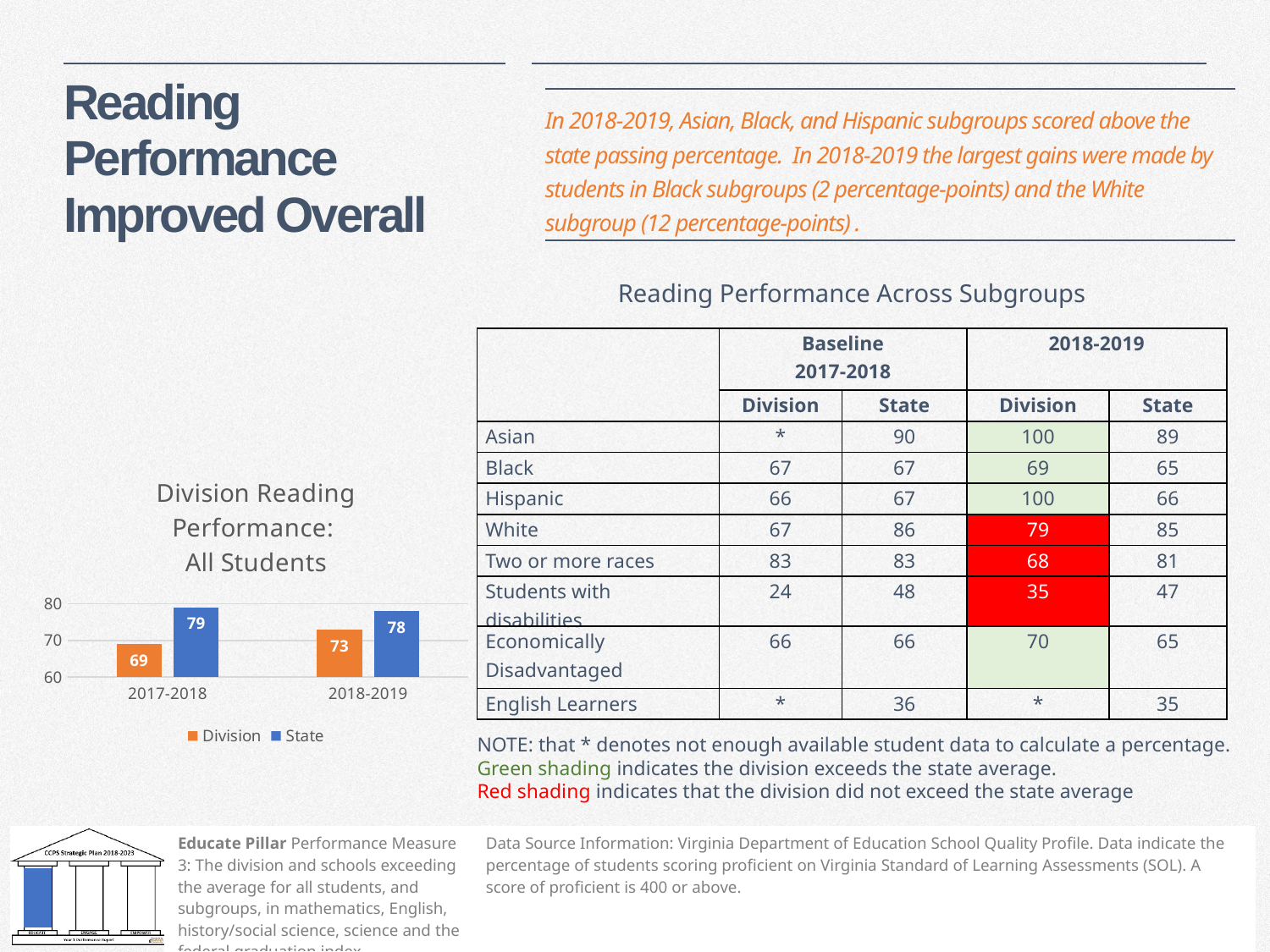
In the Division Reading Performance: All Students chart, does the State value rise or fall from 2017-2018 to 2018-2019? fall What is the State value for 2018-2019 in the Division Reading Performance: All Students chart? 78 In the Division Reading Performance: All Students chart, which year has the higher Division value? 2018-2019 In the Division Reading Performance: All Students chart, is the Division value for 2017-2018 greater or less than 70? less In the Division Reading Performance: All Students chart, by how much did the Division value increase from 2017-2018 to 2018-2019? 4 What kind of chart is the Division Reading Performance: All Students chart? bar chart What is the Division value for 2017-2018 in the Division Reading Performance: All Students chart? 69 What is the Division value for 2018-2019 in the Division Reading Performance: All Students chart? 73 How many series does the legend of the Division Reading Performance: All Students chart list? 2 In the Division Reading Performance: All Students chart, is the Division value or the State value larger for 2018-2019? State What is the State value for 2017-2018 in the Division Reading Performance: All Students chart? 79 In the Division Reading Performance: All Students chart, what is the difference between the State and Division values for 2017-2018? 10